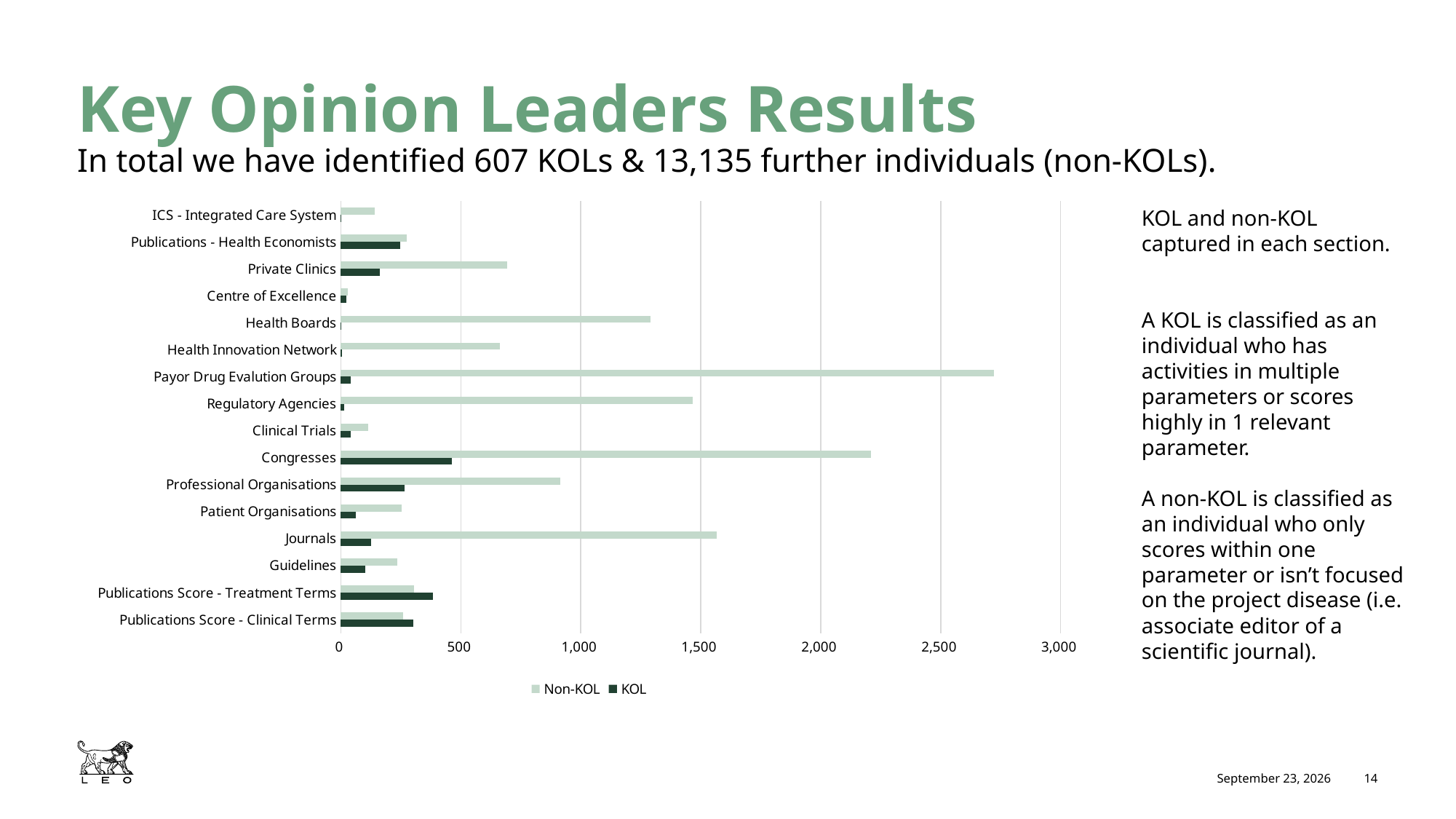
Which category has the highest KOL value? Congresses Which is larger, the Non-KOL value for Health Boards or the Non-KOL value for Private Clinics? Health Boards Which is larger, the KOL value for Publications Score - Treatment Terms or the KOL value for Guidelines? Publications Score - Treatment Terms How many series does the chart legend list? 2 What kind of chart is shown on the slide? Bar chart What are the two series named in the chart legend? Non-KOL and KOL Is the Non-KOL value for Congresses greater or less than 2,000? greater Which category has the highest Non-KOL value? Payor Drug Evalution Groups Is the KOL value for Congresses greater or less than 500? less Is the Non-KOL value for Payor Drug Evalution Groups greater or less than 2,500? greater How many categories are plotted on the chart? 16